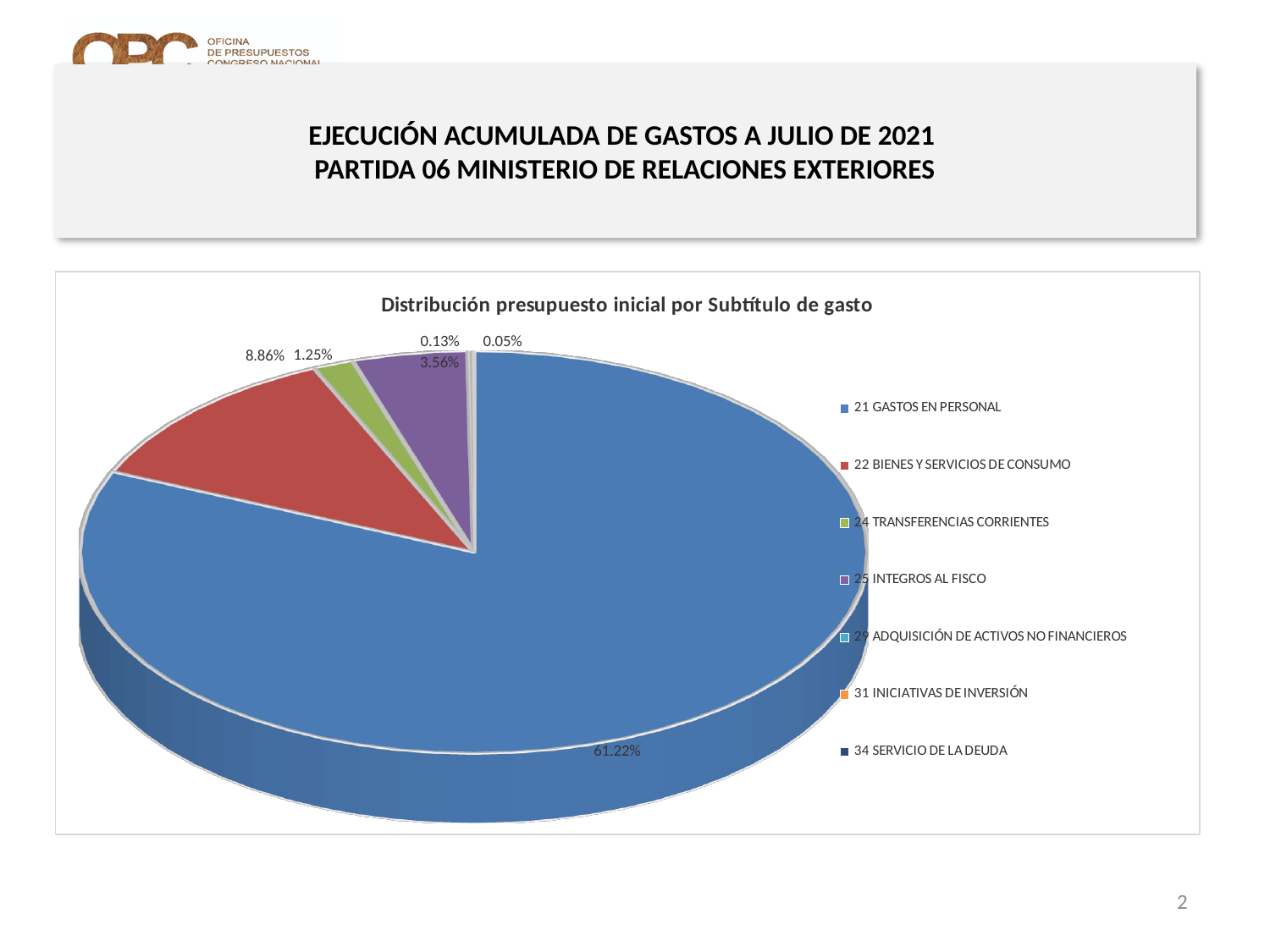
Which has the larger share: 22 BIENES Y SERVICIOS DE CONSUMO or 25 INTEGROS AL FISCO? 22 BIENES Y SERVICIOS DE CONSUMO Which has the larger share: 24 TRANSFERENCIAS CORRIENTES or 25 INTEGROS AL FISCO? 25 INTEGROS AL FISCO What percentage is shown for 24 TRANSFERENCIAS CORRIENTES? 1.25% What kind of chart is shown on the slide? Pie chart What percentage is shown for 25 INTEGROS AL FISCO? 3.56% Which category has the largest slice of the pie? 21 GASTOS EN PERSONAL What is the title of the pie chart? Distribución presupuesto inicial por Subtítulo de gasto What colour is the slice for 22 BIENES Y SERVICIOS DE CONSUMO? Red What percentage is shown for 22 BIENES Y SERVICIOS DE CONSUMO? 8.86% By how many percentage points does the share of 21 GASTOS EN PERSONAL exceed that of 22 BIENES Y SERVICIOS DE CONSUMO? 52.36 percentage points How many categories does the legend of the pie chart list? 7 What share of the pie does 21 GASTOS EN PERSONAL have? 61.22%